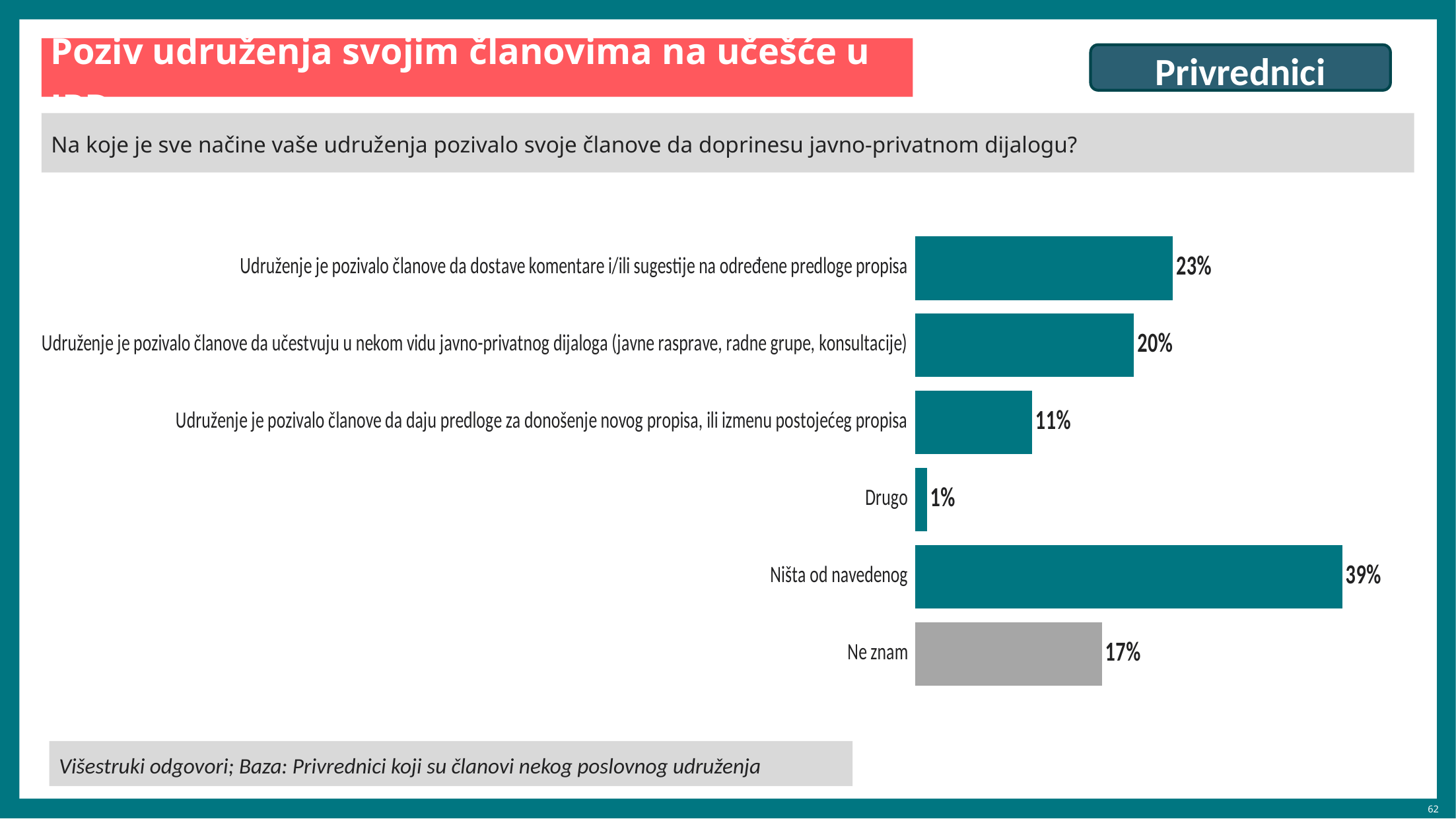
Which is larger: the value for "Ne znam" or the value for "Udruženje je pozivalo članove da daju predloge za donošenje novog propisa, ili izmenu postojećeg propisa"? Ne znam What percentage is shown for "Udruženje je pozivalo članove da daju predloge za donošenje novog propisa, ili izmenu postojećeg propisa"? 11% Which bar is coloured grey rather than teal? Ne znam What percentage is shown for "Drugo"? 1% What percentage is shown for "Ne znam"? 17% What is the difference between the values for "Ništa od navedenog" and "Ne znam"? 22% What is the difference between the values for "Udruženje je pozivalo članove da dostave komentare i/ili sugestije na određene predloge propisa" and "Udruženje je pozivalo članove da učestvuju u nekom vidu javno-privatnog dijaloga (javne rasprave, radne grupe, konsultacije)"? 3% What percentage is shown for "Ništa od navedenog"? 39% What kind of chart is shown on the slide? Bar chart How many categories are shown in the chart? 6 Which category has the highest value? Ništa od navedenog Which category has the lowest value? Drugo